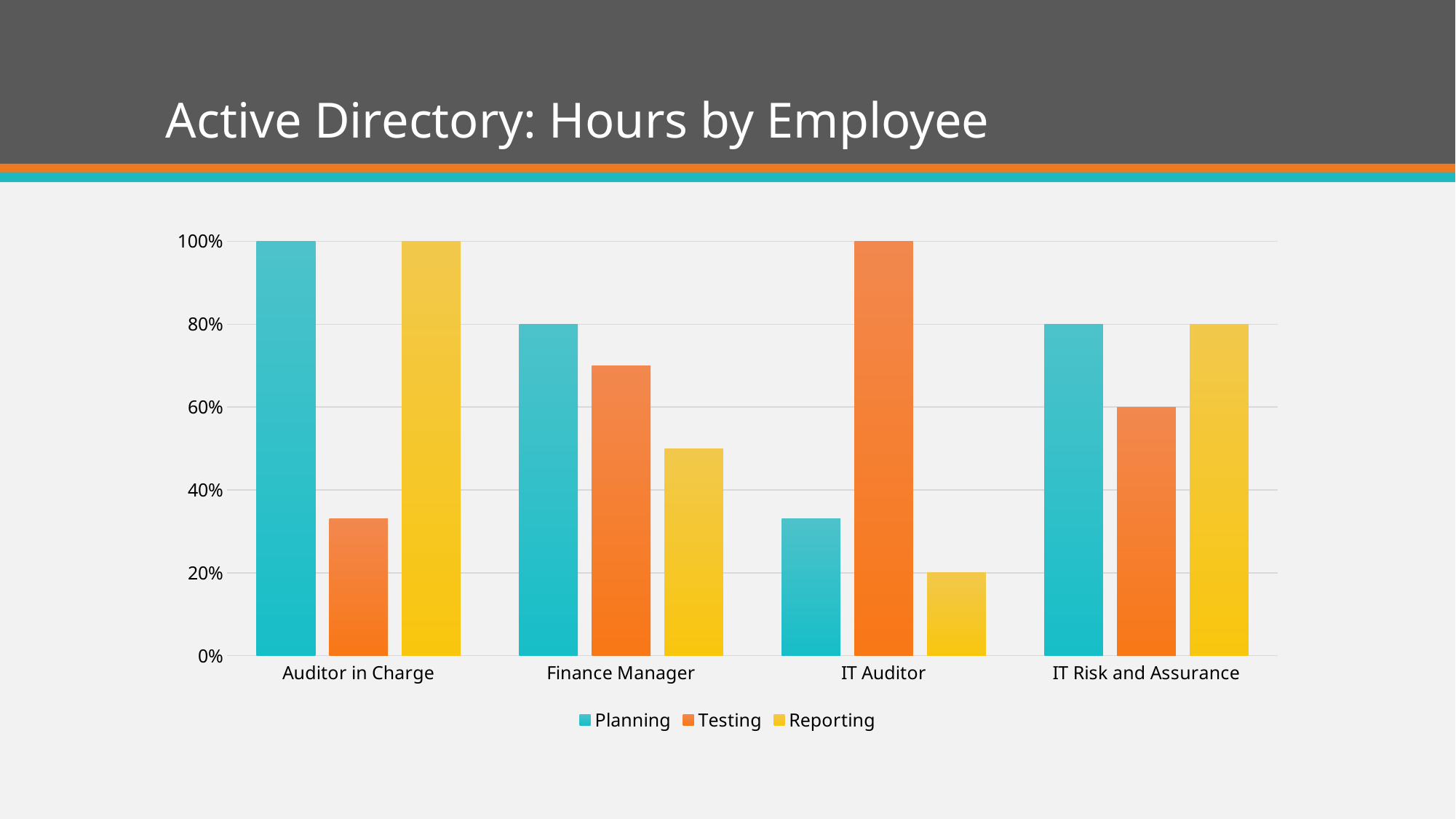
Which series has the lowest value for IT Auditor? Reporting Is the Testing value for Auditor in Charge greater or less than 40%? less What is the Testing value for IT Risk and Assurance? 60% Which is larger for Finance Manager, the Planning value or the Reporting value? Planning Is the Testing value for Finance Manager greater or less than 60%? greater What is the Planning value for Finance Manager? 80% What is the Testing value for IT Auditor? 100% What type of chart is shown on the slide? bar chart How many series does the legend list? 3 What is the Reporting value for IT Auditor? 20% How many employee categories are shown on the x axis? 4 What is the Planning value for Auditor in Charge? 100%